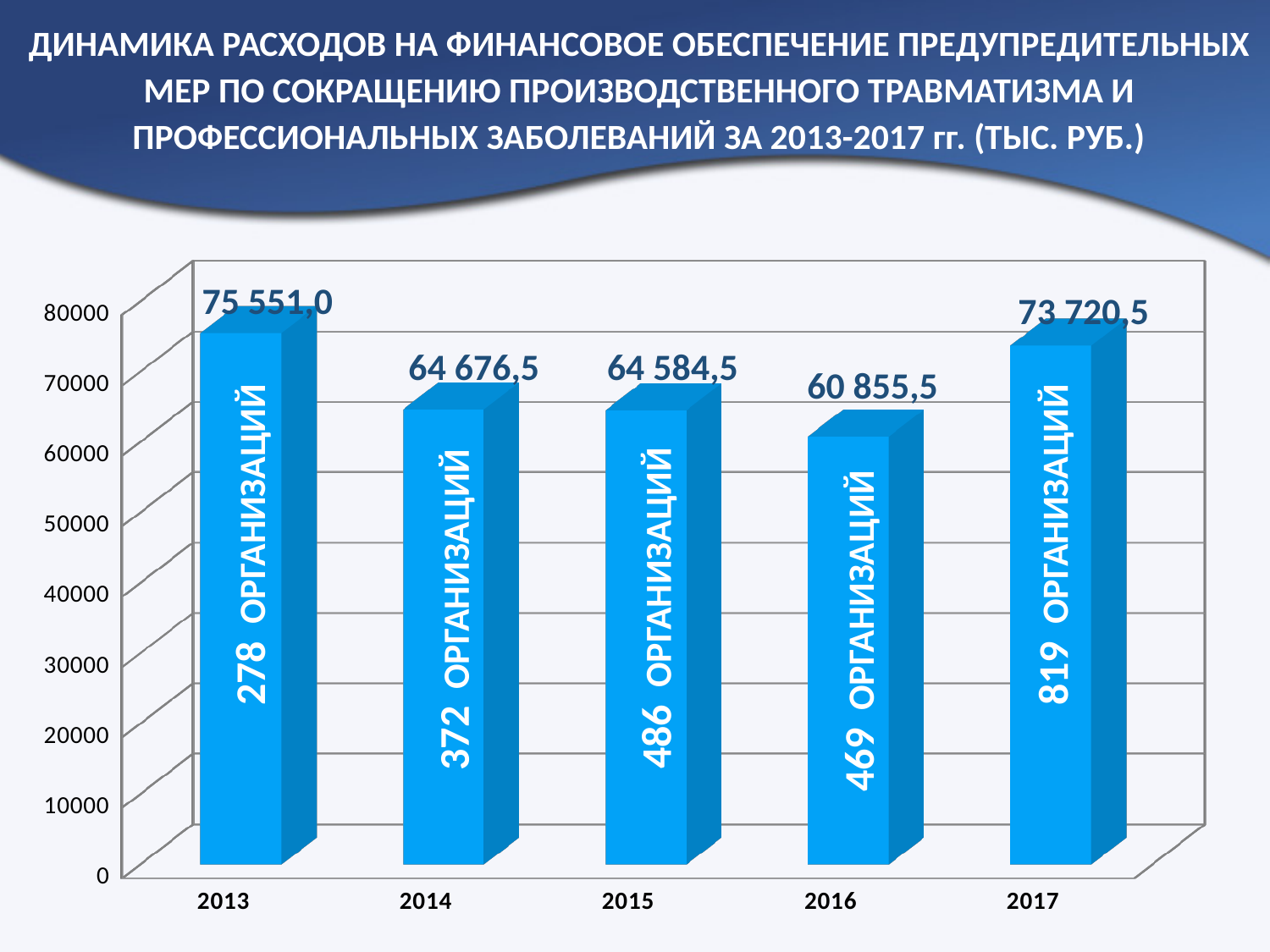
How many years are shown on the x axis? 5 Which year has the highest value? 2013 How many organizations are indicated on the bar for 2017? 819 What is the value for 2016? 60 855,5 What kind of chart is shown on the slide? bar chart Is the value for 2017 greater or less than 70000? greater What is the value for 2013? 75 551,0 Which is larger, the value for 2014 or the value for 2015? 2014 What is the value for 2017? 73 720,5 What is the difference between the values for 2013 and 2017? 1 830,5 What is the difference between the values for 2014 and 2015? 92,0 Which year has the lowest value? 2016